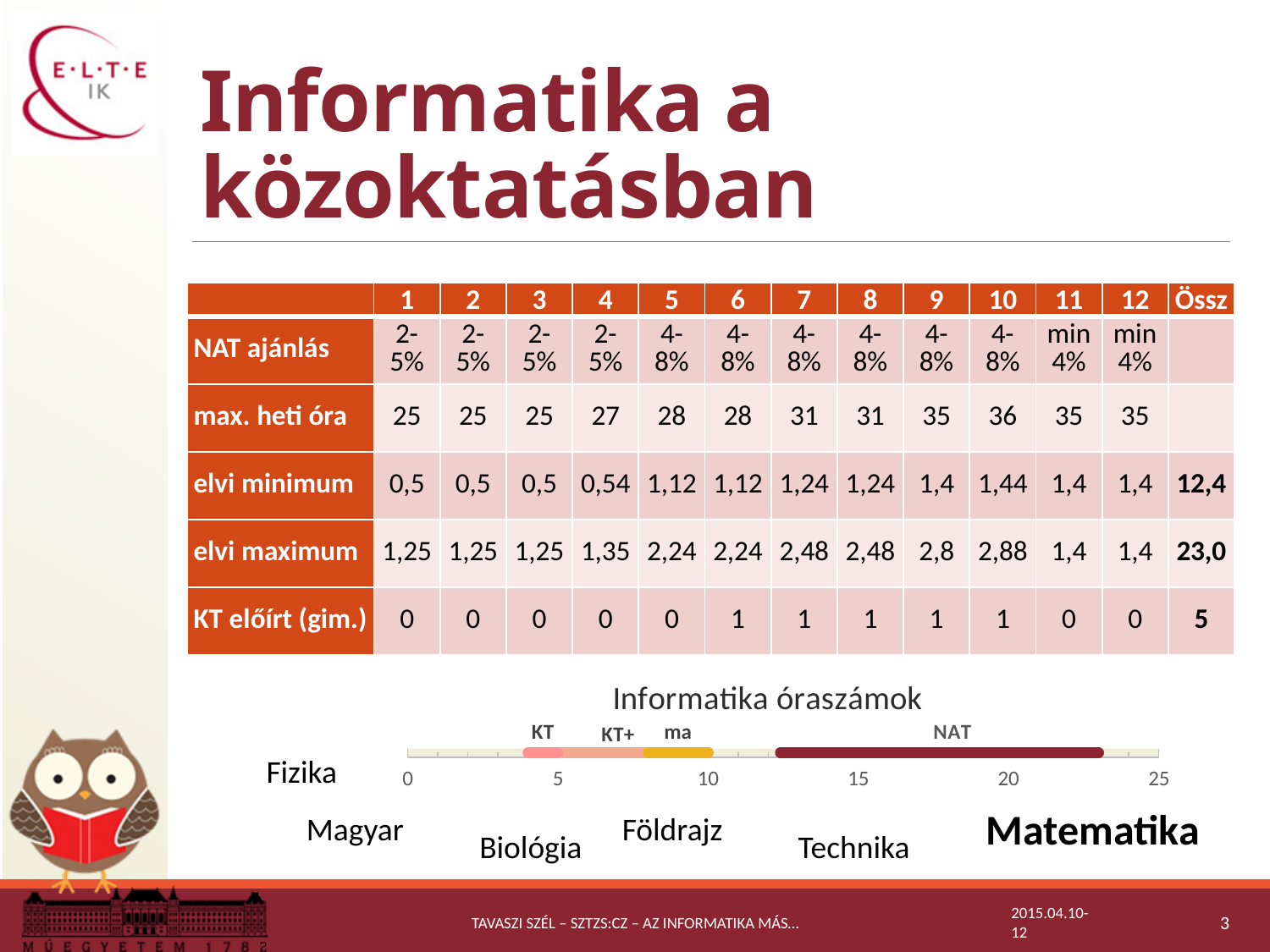
In the 'Informatika óraszámok' chart, is the bar oriented horizontally or vertically? horizontally In the 'Informatika óraszámok' chart, is the NAT segment larger or smaller than the KT segment? larger In the 'Informatika óraszámok' chart, what is the highest value shown on the horizontal axis? 25 In the 'Informatika óraszámok' chart, does the stacked bar end at a value greater or less than 20? greater In the 'Informatika óraszámok' chart, how many segment labels (series) are shown on the bar? 4 What kind of chart is shown at the bottom of the slide? bar chart What is the title of the chart at the bottom of the slide? Informatika óraszámok In the 'Informatika óraszámok' chart, which segment label appears furthest to the right on the bar? NAT In the 'Informatika óraszámok' chart, which segment of the bar is the widest? NAT